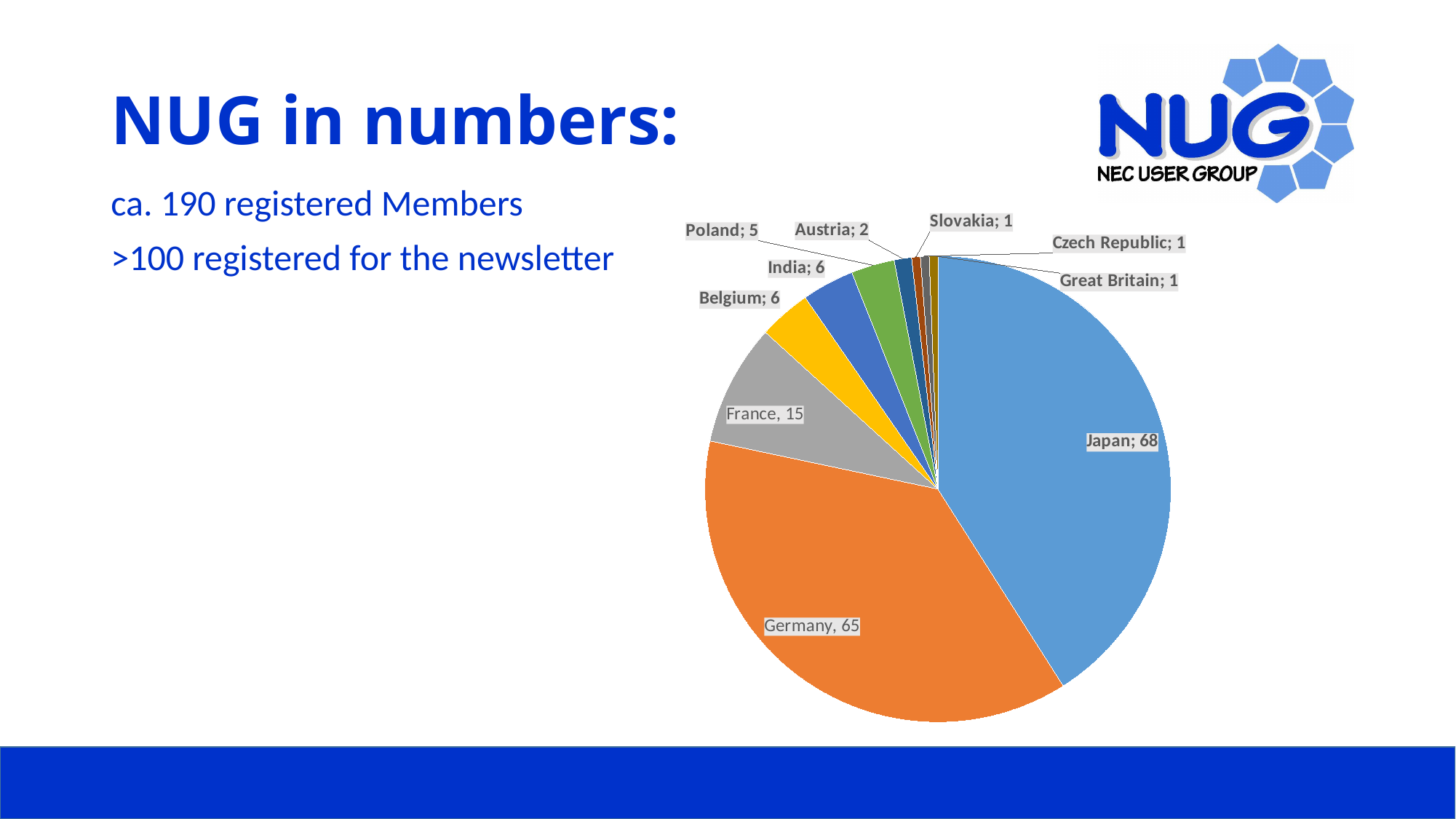
Which is larger, the value for Austria or the value for India? India What is the difference between the values for France and Belgium? 9 What is the value for Poland in the pie chart? 5 What is the value for Japan in the pie chart? 68 What is the value for France in the pie chart? 15 How many countries are shown in the pie chart? 10 What kind of chart is shown on the slide? Pie chart What is the total of all the values shown in the pie chart? 170 What is the difference between the values for Japan and Germany? 3 Which country has the largest slice in the pie chart? Japan Which is larger, the value for France or the value for Poland? France